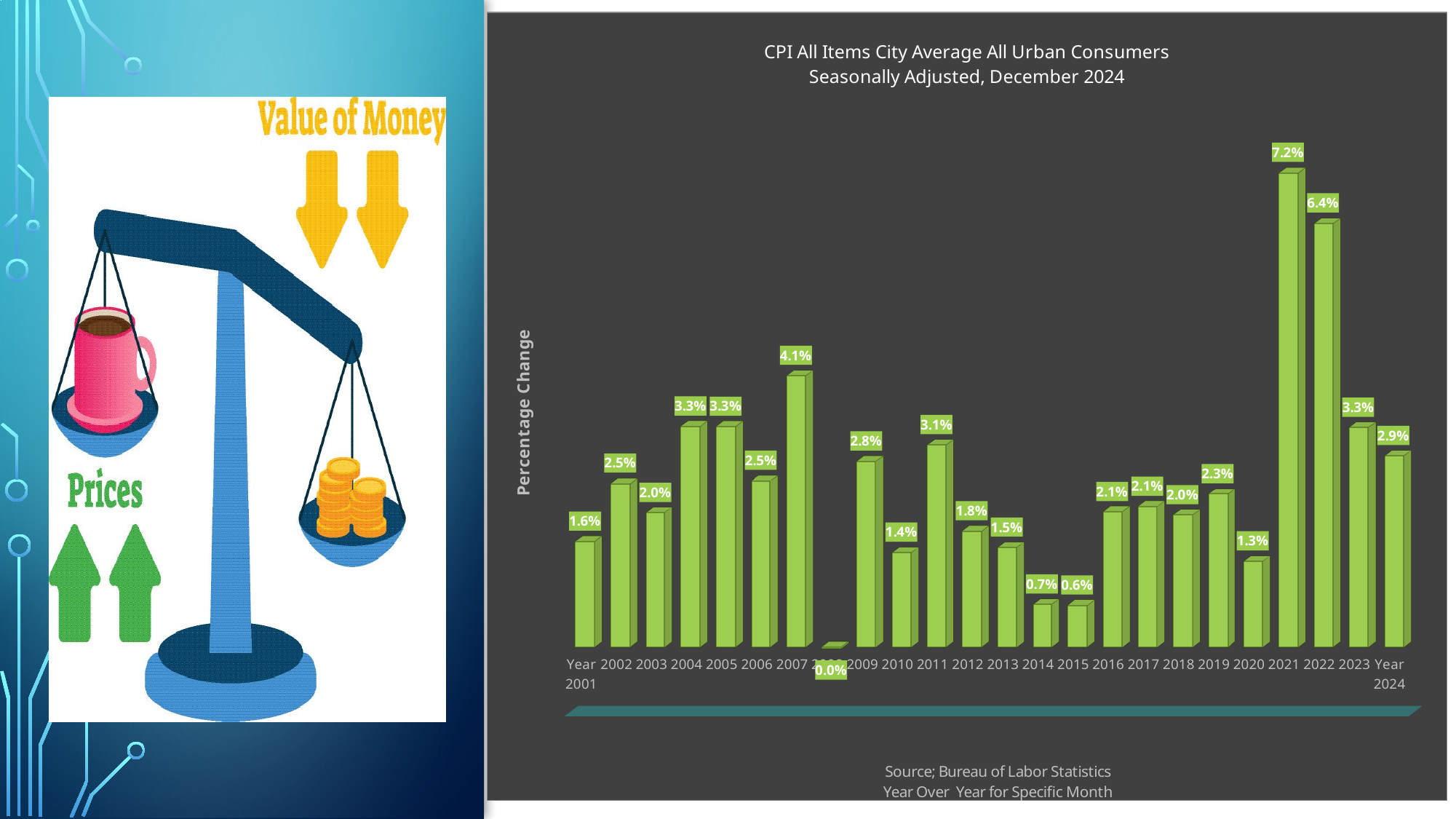
How many years are plotted on the chart? 24 What type of chart is shown on the slide? Bar chart What is the percentage change shown for Year 2024? 2.9% What is the difference between the percentage change in 2023 and in 2024? 0.4% What is the percentage change shown for 2021? 7.2% What is the percentage change shown for 2007? 4.1% What is the percentage change shown for 2015? 0.6% What is the label on the vertical axis of the chart? Percentage Change Which year has a larger percentage change, 2009 or 2011? 2011 What is the difference between the percentage change in 2021 and in 2022? 0.8% Which year has the lowest percentage change? 2008 Which year has the highest percentage change? 2021